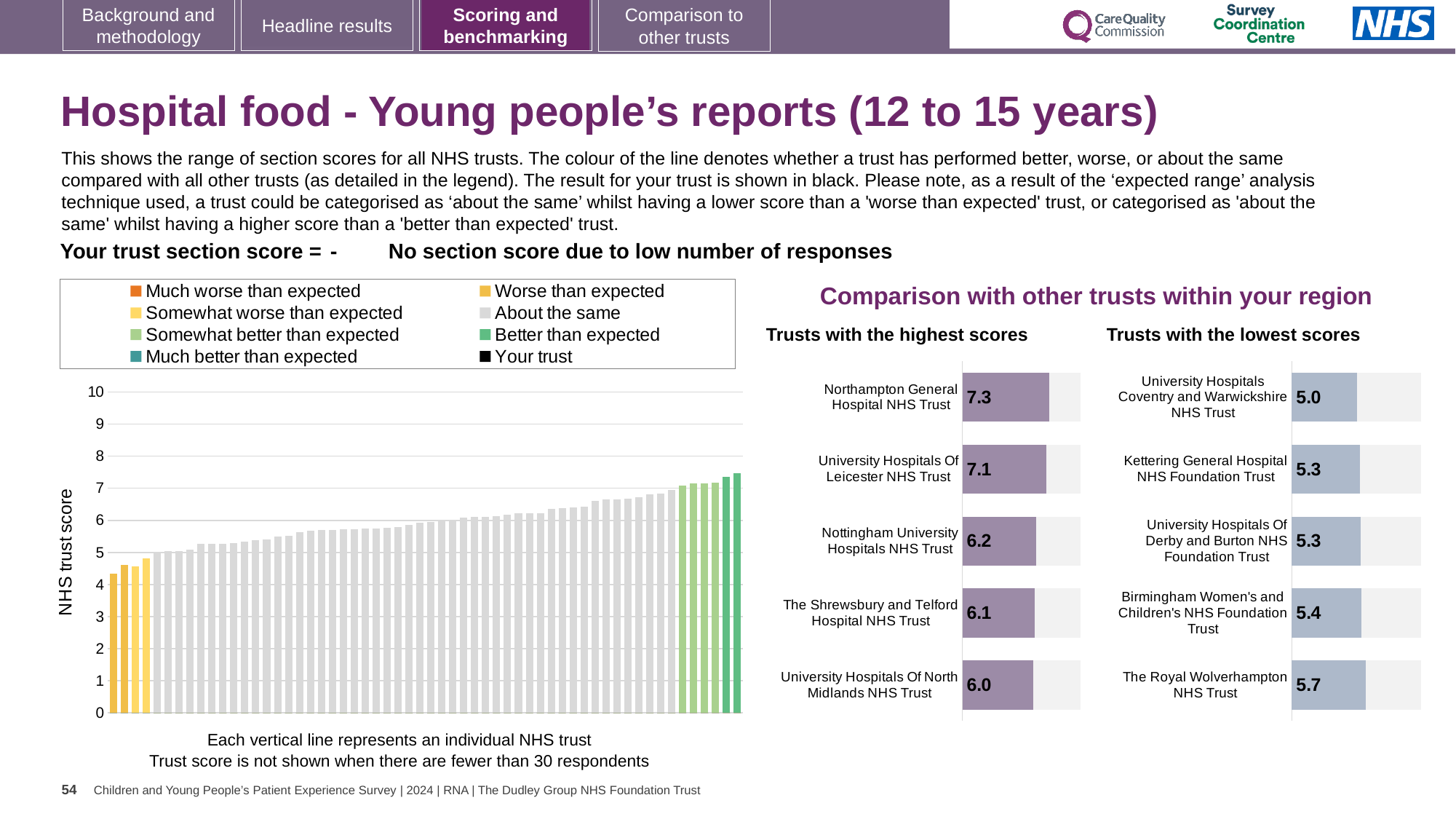
What kind of chart is the NHS trust score chart on the left? Bar chart In the 'Trusts with the highest scores' chart, what is the difference between the scores of Northampton General Hospital NHS Trust and University Hospitals Of Leicester NHS Trust? 0.2 In the 'Trusts with the lowest scores' chart, which trust has the highest score? The Royal Wolverhampton NHS Trust How many trusts are shown in the 'Trusts with the lowest scores' chart? 5 In the 'Trusts with the lowest scores' chart, what is the difference between the scores of The Royal Wolverhampton NHS Trust and University Hospitals Coventry and Warwickshire NHS Trust? 0.7 In the 'Trusts with the highest scores' chart, which trust has the lowest score? University Hospitals Of North Midlands NHS Trust In the 'Trusts with the lowest scores' chart, what is the score for University Hospitals Coventry and Warwickshire NHS Trust? 5.0 In the NHS trust score chart on the left, is the value of the shortest bar greater or less than 4? greater In the 'Trusts with the highest scores' chart, what is the score for Northampton General Hospital NHS Trust? 7.3 In the NHS trust score chart on the left, is the value of the tallest bar greater or less than 8? less In the 'Trusts with the lowest scores' chart, what is the score for Birmingham Women's and Children's NHS Foundation Trust? 5.4 In the 'Trusts with the highest scores' chart, which has the larger score: Nottingham University Hospitals NHS Trust or The Shrewsbury and Telford Hospital NHS Trust? Nottingham University Hospitals NHS Trust